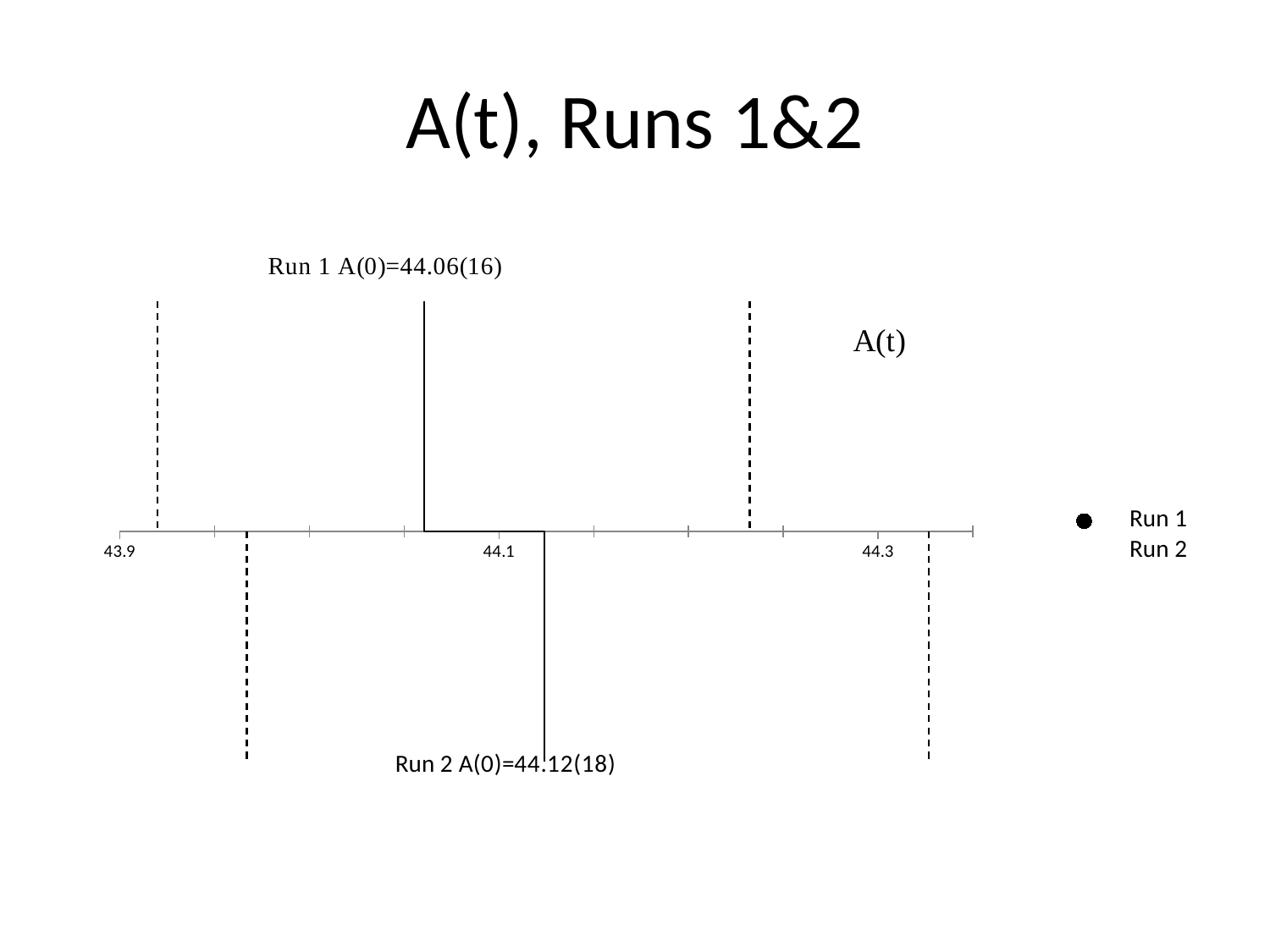
Is the A(0) value for Run 2 greater or less than 44.1? greater What is the difference between the A(0) central values of Run 2 and Run 1? 0.06 What is the lowest value labelled on the horizontal axis? 43.9 Which run's solid line extends upward from the axis? Run 1 What is the labelled value of A(0) for Run 1? 44.06(16) What is the highest value labelled on the horizontal axis? 44.3 How many series does the legend list? 2 Is the A(0) value for Run 1 greater or less than 44.1? less Which run has the larger A(0) value, Run 1 or Run 2? Run 2 What is the title of the chart on the slide? A(t), Runs 1&2 What is the labelled value of A(0) for Run 2? 44.12(18) How many runs are plotted on the chart? 2